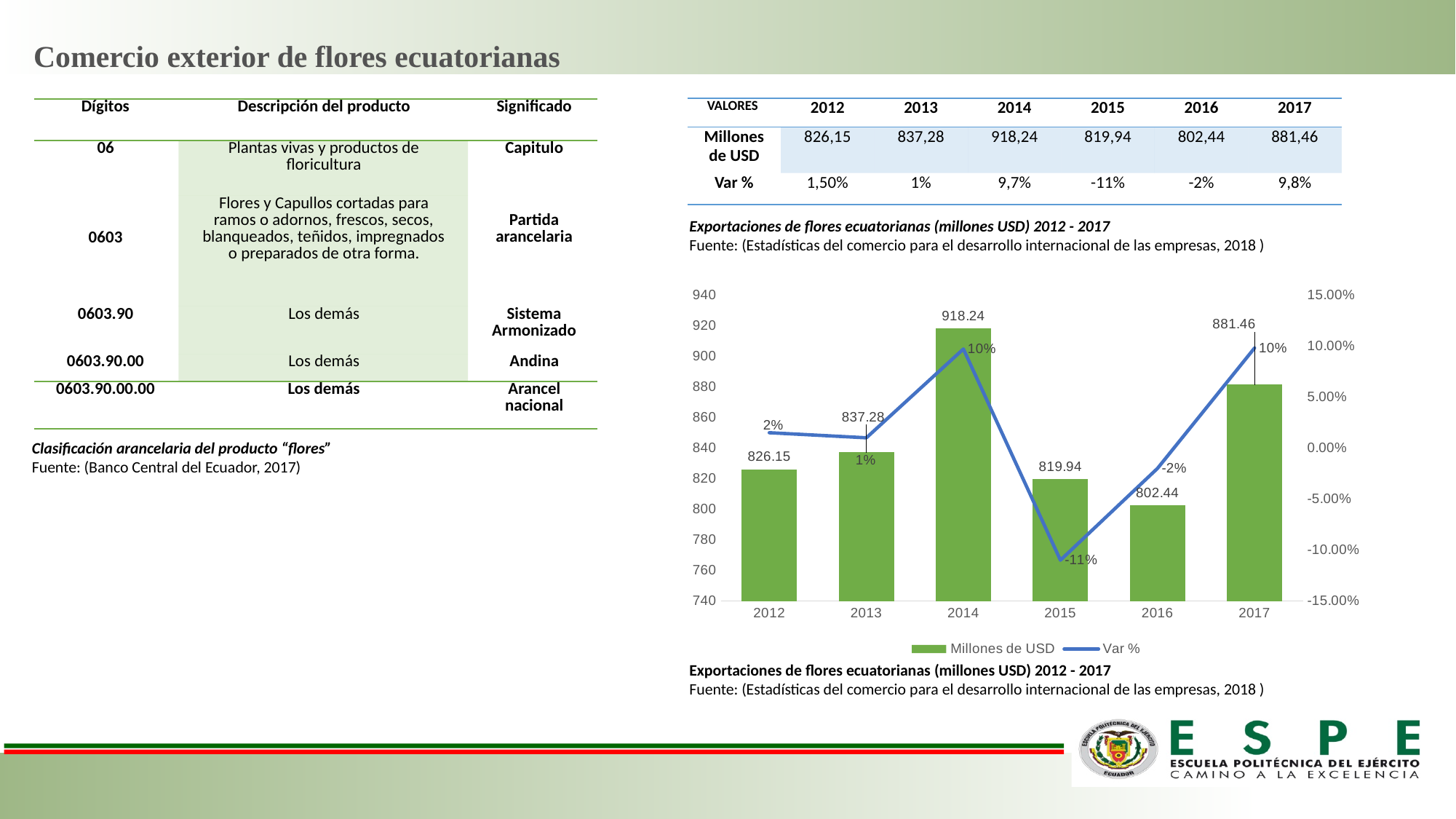
Which year has the highest Millones de USD bar in the chart? 2014 What is the value of Millones de USD for 2014 in the chart? 918.24 How many series does the chart legend list? 2 Which year has the lowest Millones de USD bar in the chart? 2016 What is the difference in Millones de USD between 2014 and 2015 in the chart? 98.30 What Var % is shown for 2015 in the chart? -11% Is the Millones de USD value for 2012 greater or less than 840? less What kind of chart is used to show Millones de USD? bar chart How many years are shown on the x axis of the chart? 6 What is the value of Millones de USD for 2016 in the chart? 802.44 Does the Millones de USD value rise or fall from 2016 to 2017 in the chart? rise Which is larger in the chart, the Millones de USD value for 2013 or for 2017? 2017